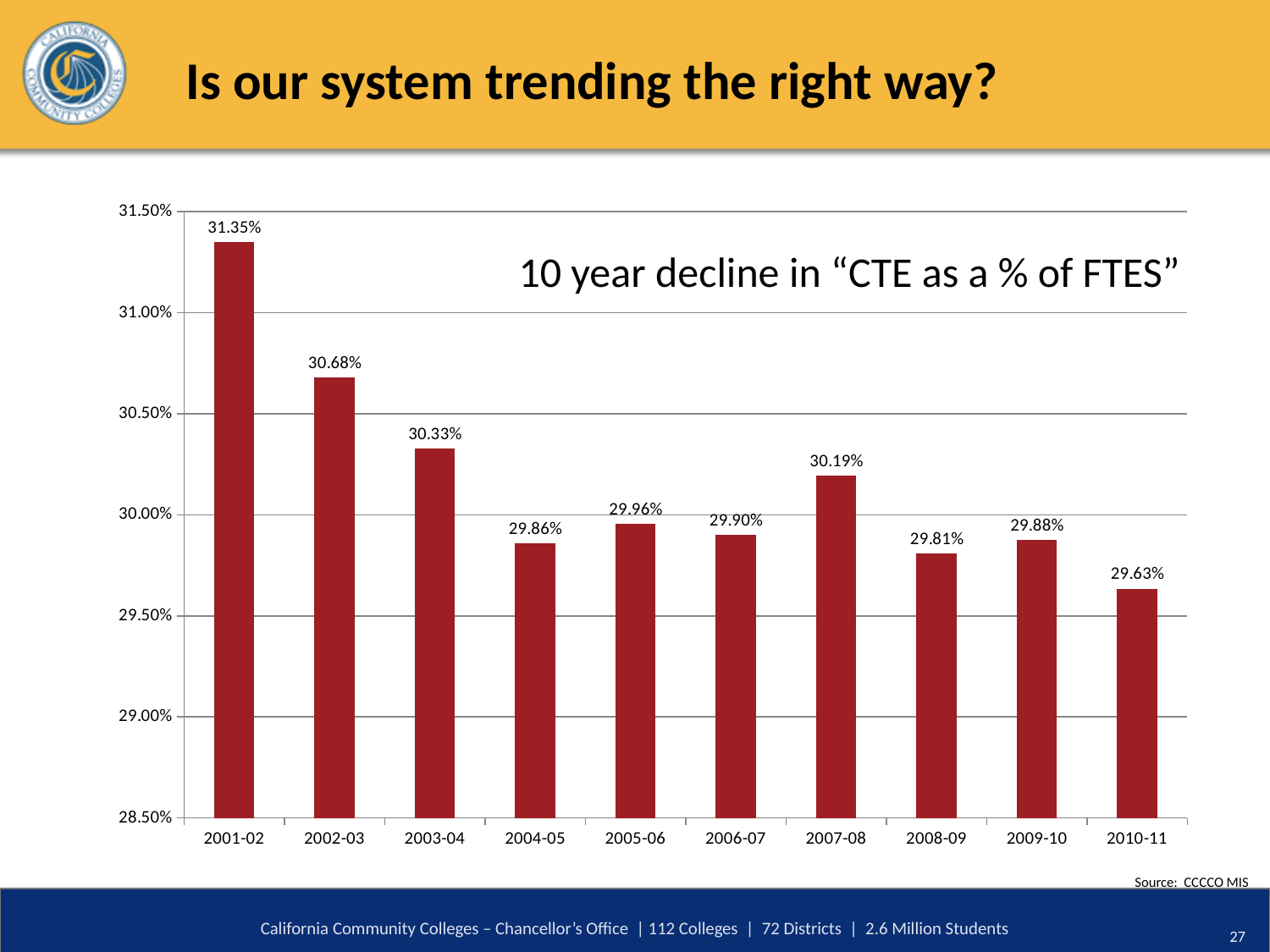
How many years are shown on the x axis? 10 What kind of chart is shown on the slide? bar chart Which year has the lowest value? 2010-11 Is the value for 2004-05 greater or less than 30.00%? less What is the source cited for the chart? CCCCO MIS Which year has the highest value? 2001-02 What is the value for 2001-02? 31.35% Do the values generally rise or fall from 2001-02 to 2010-11? fall Which is larger, the value for 2003-04 or the value for 2007-08? 2003-04 What is the value for 2007-08? 30.19% What is the value for 2010-11? 29.63% What is the difference between the values for 2001-02 and 2010-11? 1.72%